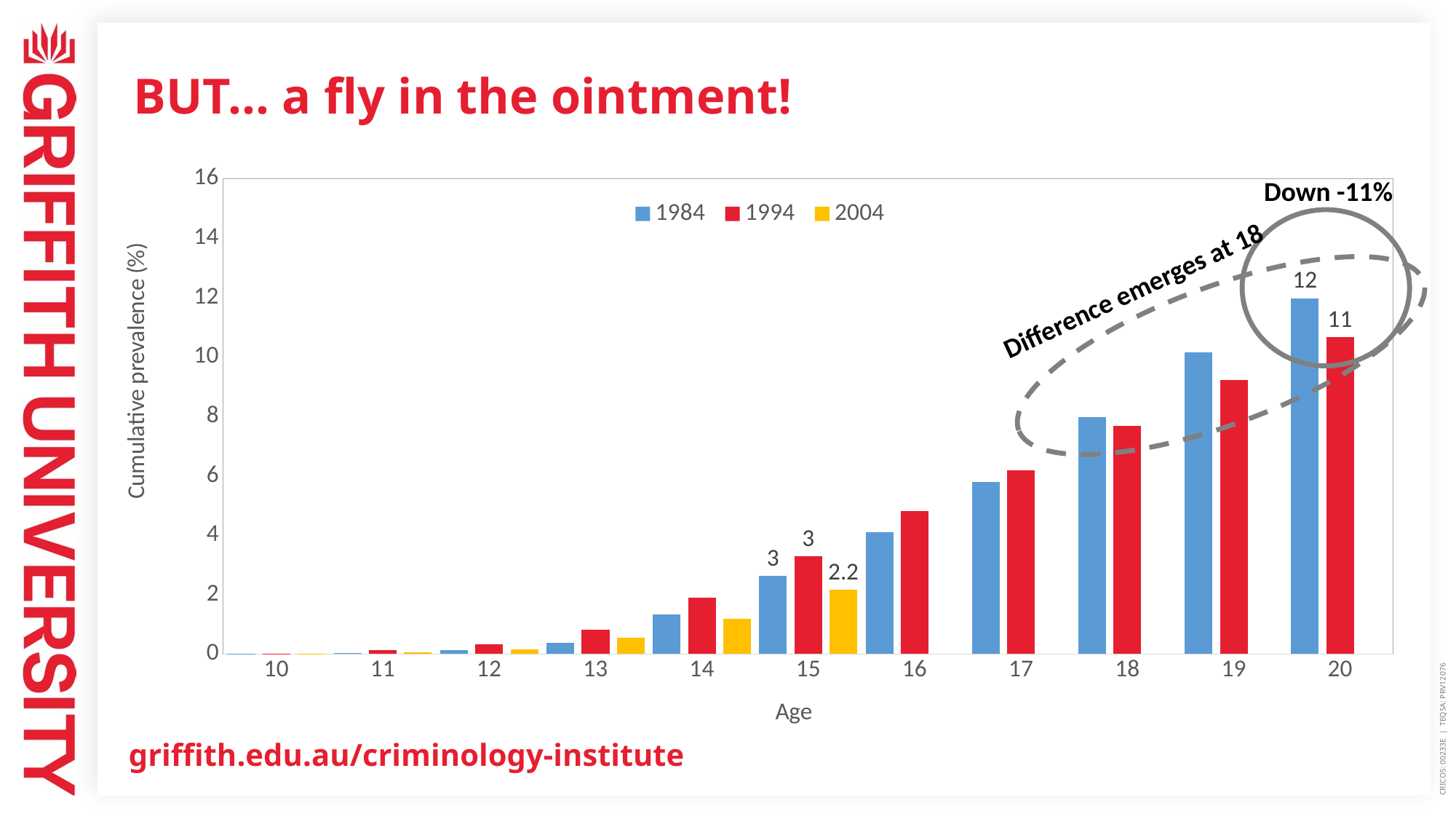
What is the difference between the 1984 and 1994 values at age 20? 1 What is the cumulative prevalence for the 2004 series at age 15? 2.2 What kind of chart is shown on the slide? bar chart What is the title of the y axis? Cumulative prevalence (%) At age 15, which series has the larger value: 1994 or 2004? 1994 What is the cumulative prevalence for the 1984 series at age 20? 12 How many age categories are shown on the x axis? 11 Do the values for the 1984 series rise or fall as age increases from 10 to 20? rise What is the cumulative prevalence for the 1994 series at age 20? 11 Is the value for the 1994 series at age 18 greater or less than 8? less Is the value for the 1984 series at age 19 greater or less than 8? greater How many series does the legend list? 3